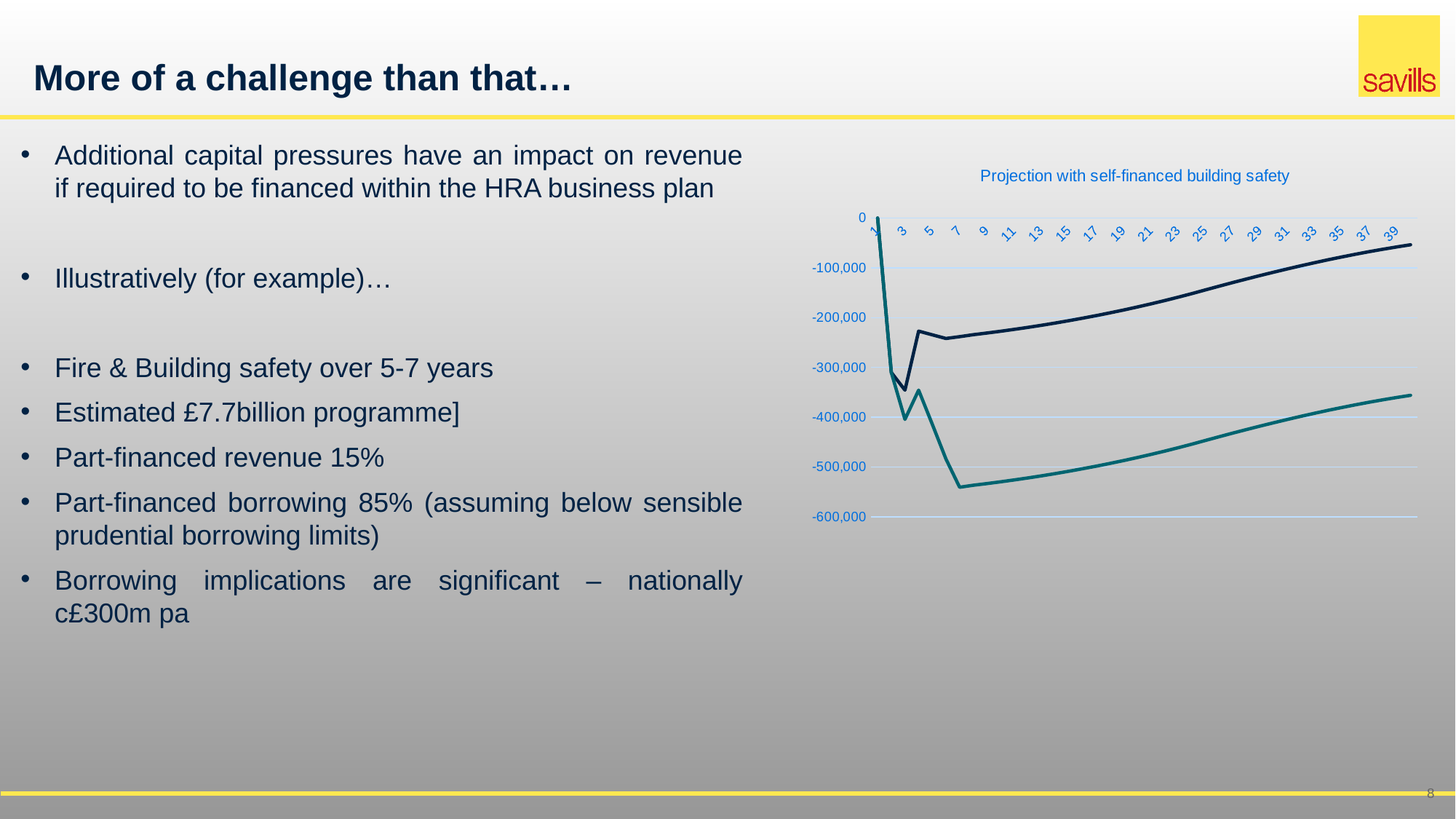
What is the last label shown on the x axis? 39 How many lines are plotted on the chart? 2 At which x value does the teal line reach its lowest point? 7 What is the title of the chart? Projection with self-financed building safety From x = 7 to x = 39, do the values of the teal line rise or fall? rise Which line is lower at x = 39, the dark navy line or the teal line? the teal line Is the value of the teal line at x = 7 greater or less than -500,000? less What kind of chart is shown on the slide? line chart Is the value of the teal line at x = 39 greater or less than -400,000? greater Is the value of the dark navy line at x = 39 greater or less than -100,000? greater What is the lowest value labelled on the y axis? -600,000